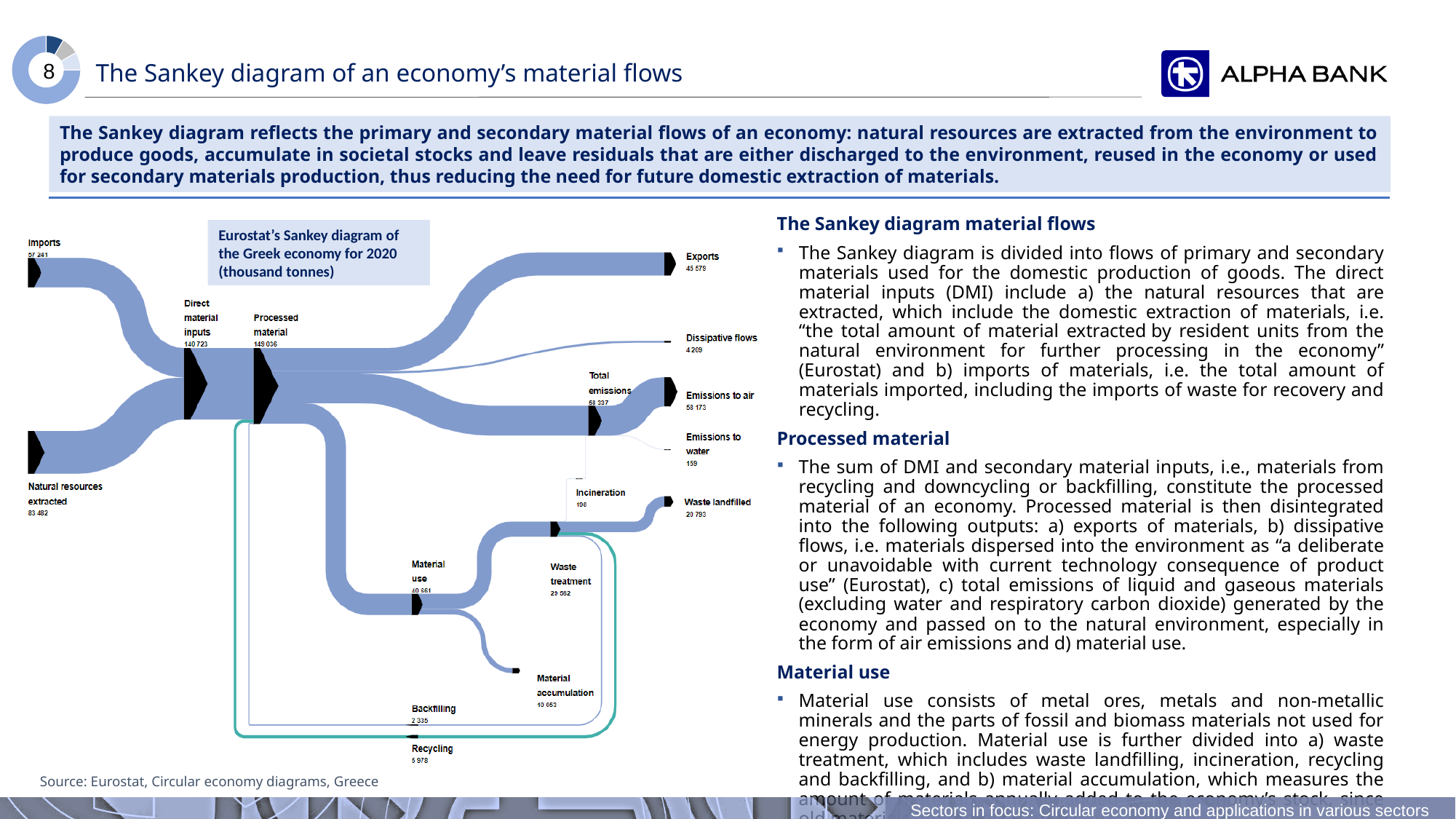
Which is larger, Imports or Natural resources extracted? Natural resources extracted What is the value for Waste landfilled? 20 793 What is the value for Exports? 45 579 What is the value for Direct material inputs? 140 723 What is the value for Processed material? 149 036 Which is larger, Emissions to air or Exports? Emissions to air What is the value for Imports in the Sankey diagram? 57 241 In what unit are the values in the Sankey diagram expressed, according to its title box? thousand tonnes What kind of chart is shown on the slide? Sankey diagram What is the difference between Natural resources extracted and Imports? 26 241 What is the value for Natural resources extracted? 83 482 What is the difference between Processed material and Direct material inputs? 8 313